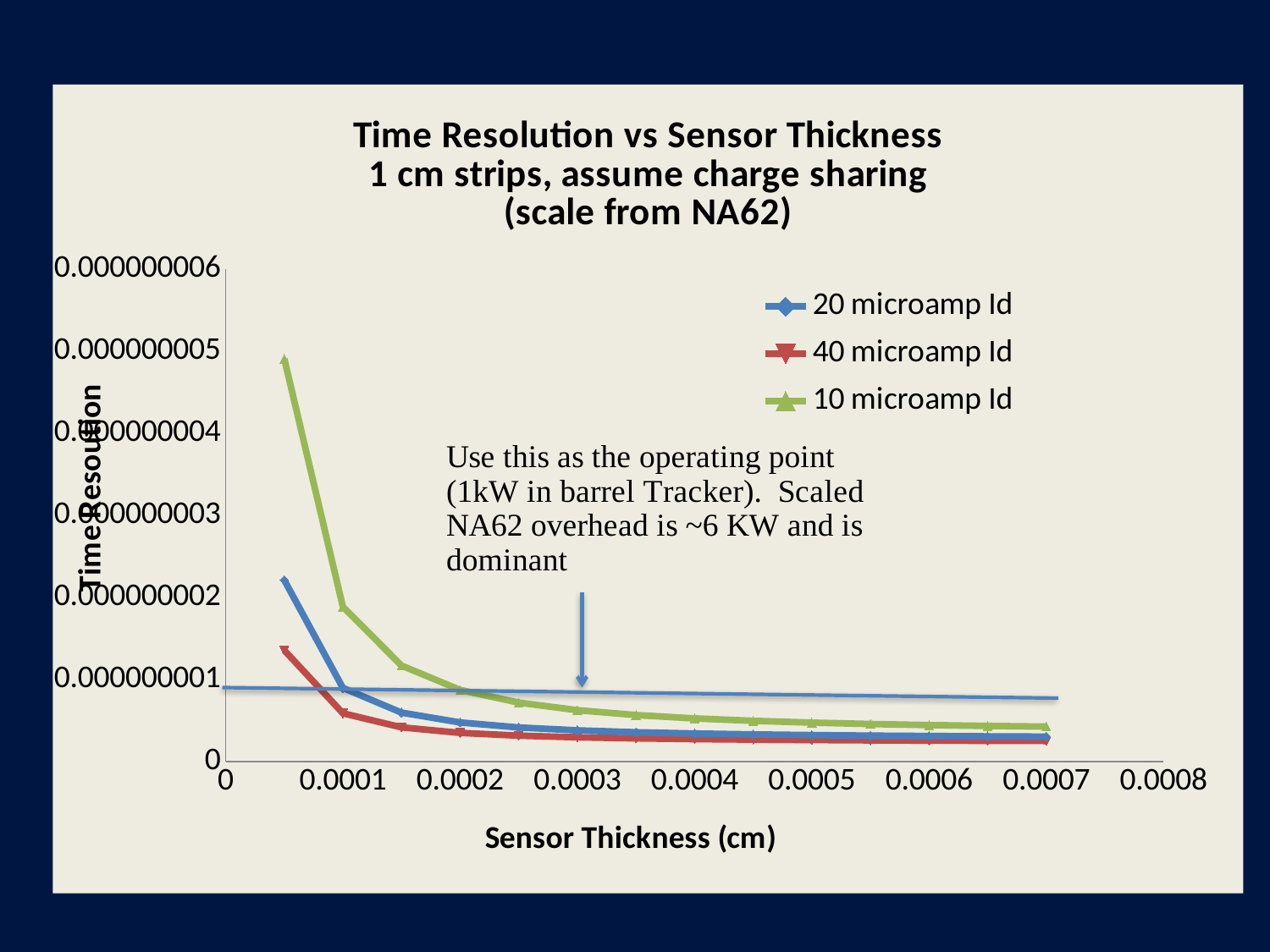
Which series has the highest time resolution at the smallest sensor thickness plotted? 10 microamp Id Is the value for the 10 microamp Id series at a sensor thickness of 0.00005 greater or less than 0.000000004? greater At a sensor thickness of 0.00005, which series has the larger value: 10 microamp Id or 20 microamp Id? 10 microamp Id Is the value for the 20 microamp Id series at a sensor thickness of 0.00005 greater or less than 0.000000002? greater What is the label of the x axis? Sensor Thickness (cm) How many series does the legend list? 3 Is the value for the 40 microamp Id series at a sensor thickness of 0.0001 greater or less than 0.000000001? less Do the time resolution values rise or fall as sensor thickness increases? fall What is the title of the chart? Time Resolution vs Sensor Thickness 1 cm strips, assume charge sharing (scale from NA62) Which series has the lowest time resolution at the smallest sensor thickness plotted? 40 microamp Id What kind of chart is shown on the slide? line chart